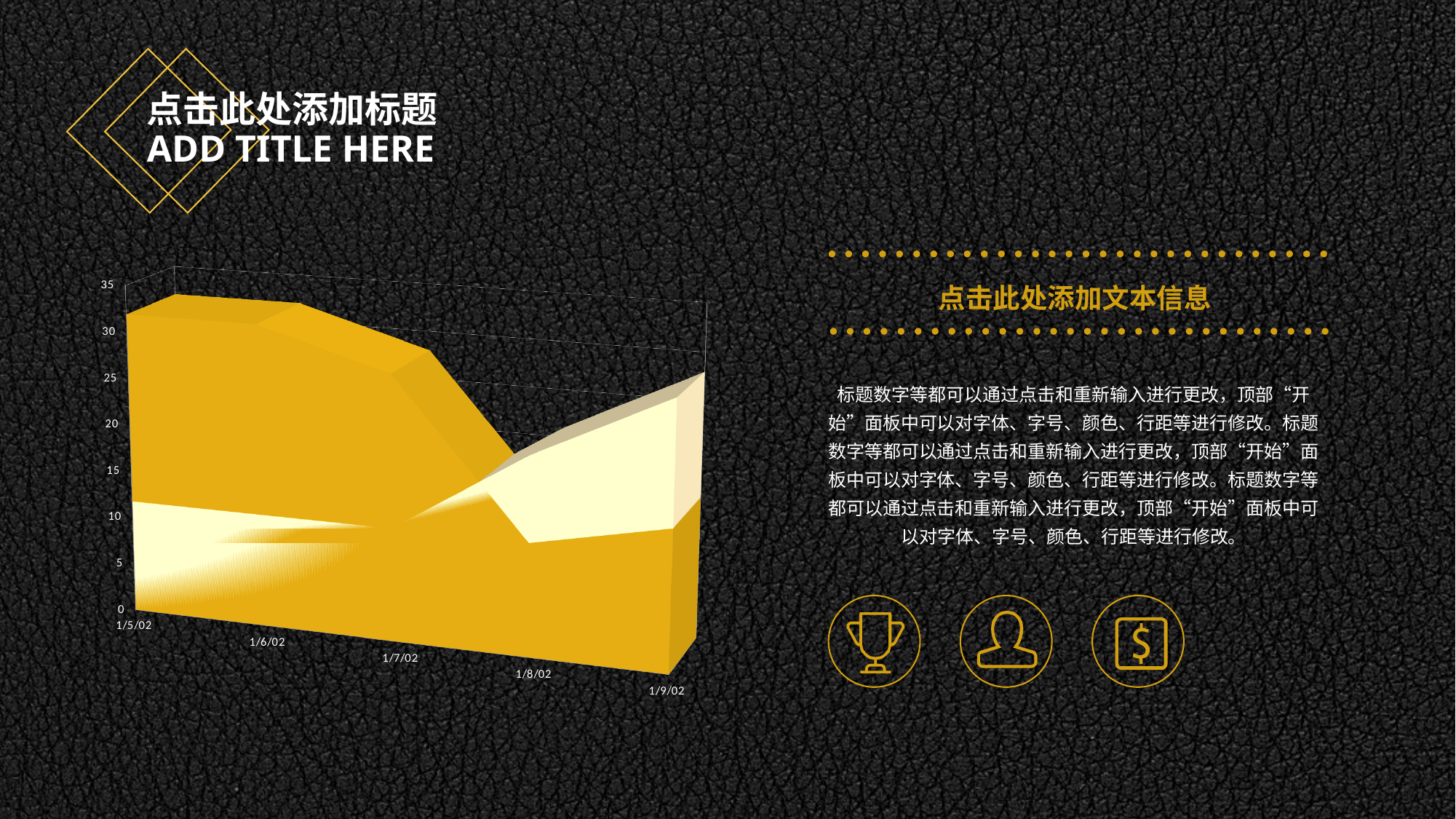
Does the back (light yellow) series rise or fall from 1/7/02 to 1/9/02? rise Is the value of the front (dark yellow) series at 1/5/02 greater or less than 20? greater Is the value of the back (light yellow) series at 1/6/02 greater or less than 20? less How many dates are shown on the x axis of the chart? 5 What is the first date label on the x axis of the chart? 1/5/02 What kind of chart is shown on the slide? area chart Is the value of the front (dark yellow) series at 1/9/02 greater or less than 20? less What is the last date label on the x axis of the chart? 1/9/02 Does the front (dark yellow) series rise or fall from 1/6/02 to 1/9/02? fall Which date has the highest value for the front (dark yellow) series, 1/5/02 or 1/9/02? 1/5/02